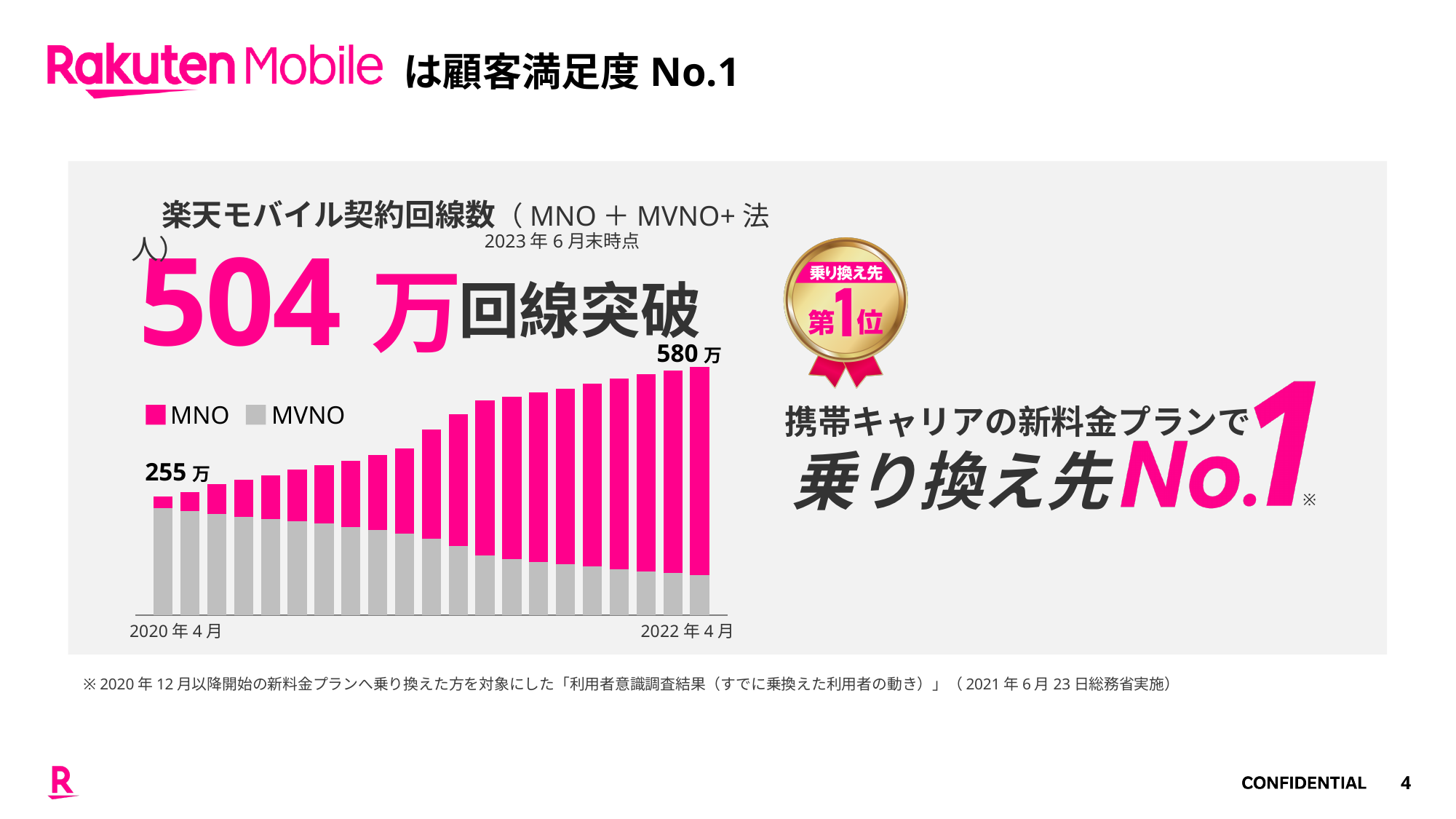
What is the total value labelled on the first bar (2020年4月)? 255万 Which bar has a larger total, the first bar (2020年4月) or the last bar (2022年4月)? 2022年4月 Does the MNO (pink) portion of the bars rise or fall from 2020年4月 to 2022年4月? Rise What kind of chart is shown on the slide? Stacked bar chart What is the total value labelled on the last bar (2022年4月)? 580万 Which colour represents the MNO series in the chart? Pink What is the difference between the labelled total of the last bar (580万) and the first bar (255万)? 325万 In the last bar (2022年4月), which series takes up the larger portion, MNO or MVNO? MNO Do the total bar heights rise or fall from 2020年4月 to 2022年4月? Rise Does the MVNO (gray) portion of the bars rise or fall from 2020年4月 to 2022年4月? Fall How many series does the chart legend list? 2 What are the two series named in the chart legend? MNO and MVNO